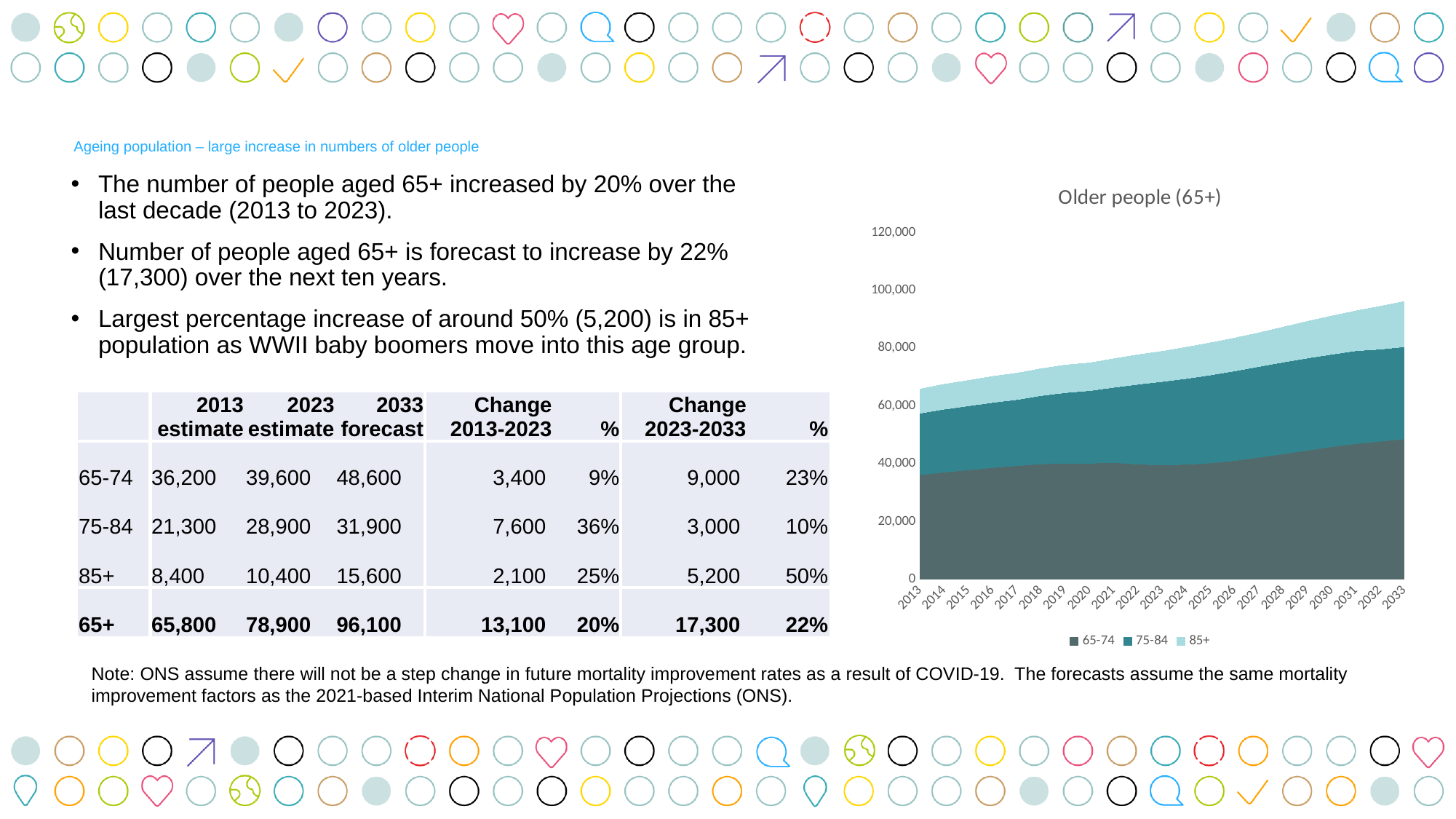
Is the total stacked value for 2033 in the chart greater or less than 80,000? greater Is the total stacked value for 2033 in the chart greater or less than 100,000? less How many years are shown along the x axis of the chart? 21 Is the value for the 65-74 series in 2013 greater or less than 40,000? less What type of chart is shown on the slide? Stacked area chart What is the title of the chart? Older people (65+) Does the total number of older people (65+) rise or fall from 2013 to 2033 in the chart? Rise What is the first year shown on the chart's x axis? 2013 How many series does the chart's legend list? 3 Which age groups are listed in the chart's legend? 65-74, 75-84, 85+ What is the last year shown on the chart's x axis? 2033